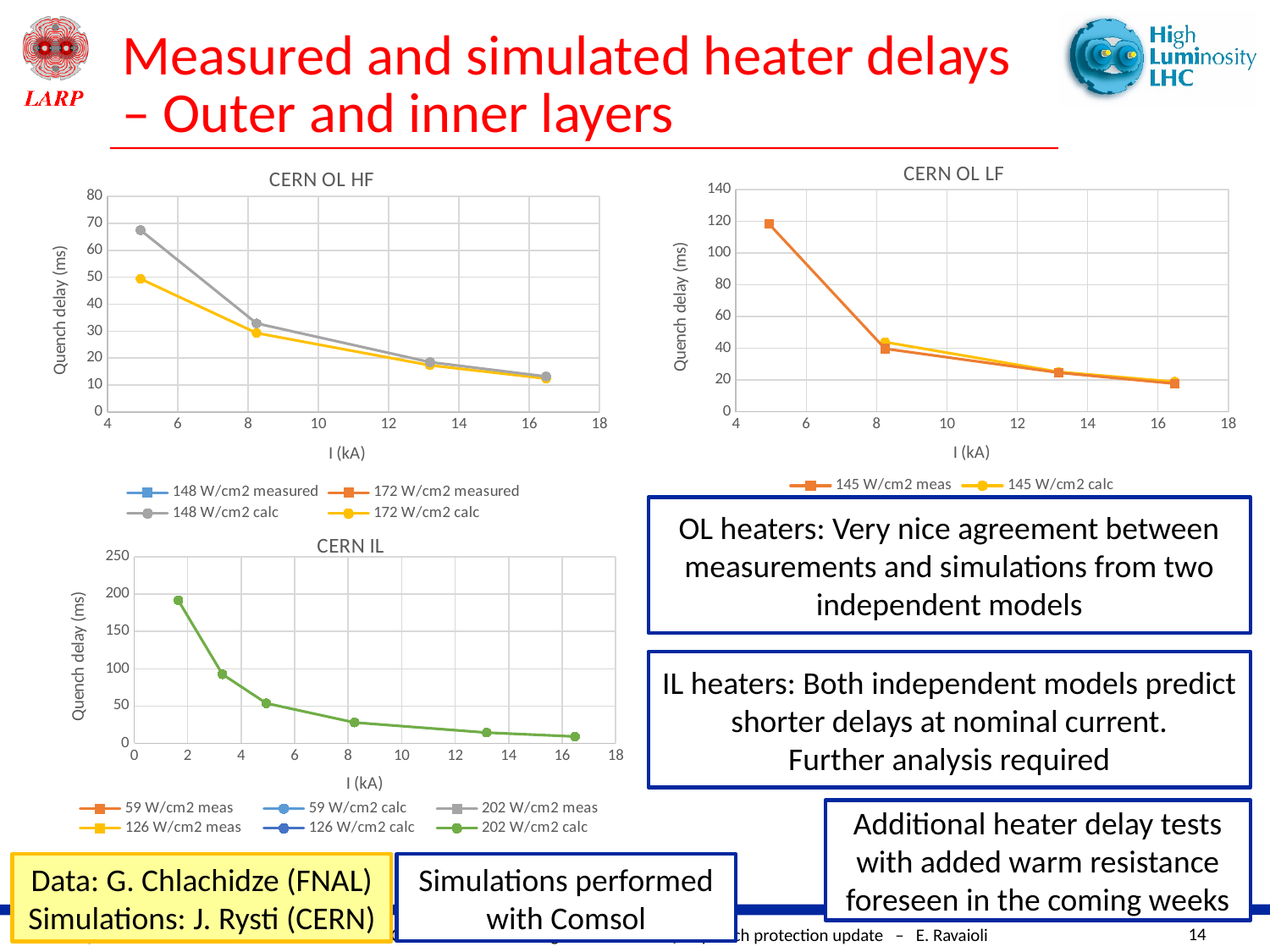
How many series does the legend of the CERN IL chart list? 6 In the CERN OL HF chart, at the lowest current point, which series has the higher quench delay: 148 W/cm2 calc or 172 W/cm2 calc? 148 W/cm2 calc What type of chart is the CERN OL HF chart? line chart How many series does the legend of the CERN OL LF chart list? 2 In the CERN OL LF chart, does the quench delay rise or fall as the current increases? fall In the CERN OL HF chart, is the quench delay of the 148 W/cm2 calc series at its lowest current point greater or less than 60 ms? greater In the CERN OL HF chart, does the quench delay rise or fall as the current I (kA) increases? fall In the CERN IL chart, is the quench delay of the 202 W/cm2 calc series at its lowest current point greater or less than 150 ms? greater How many series does the legend of the CERN OL HF chart list? 4 What is the label of the y axis on the CERN OL LF chart? Quench delay (ms) In the CERN OL LF chart, is the quench delay at the lowest current point greater or less than 100 ms? greater What is the label of the x axis on the CERN IL chart? I (kA)